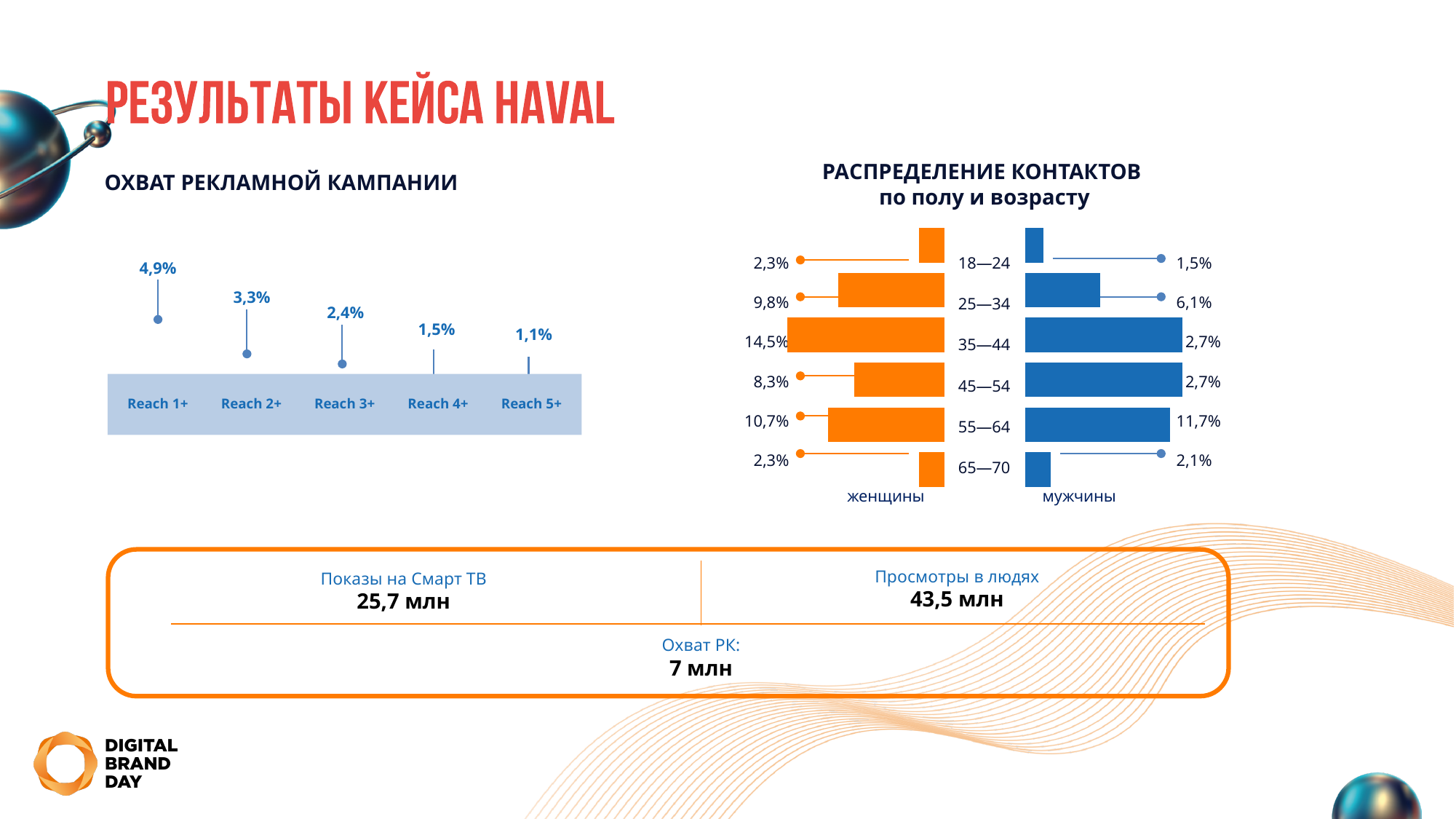
In the chart 'ОХВАТ РЕКЛАМНОЙ КАМПАНИИ', which category has the lowest value? Reach 5+ In the chart 'РАСПРЕДЕЛЕНИЕ КОНТАКТОВ по полу и возрасту', what is the value for женщины aged 35—44? 14,5% In the chart 'ОХВАТ РЕКЛАМНОЙ КАМПАНИИ', what is the value for Reach 1+? 4,9% How many categories are shown in the chart 'ОХВАТ РЕКЛАМНОЙ КАМПАНИИ'? 5 In the chart 'ОХВАТ РЕКЛАМНОЙ КАМПАНИИ', what is the difference between Reach 1+ and Reach 2+? 1,6% How many age groups are shown in the chart 'РАСПРЕДЕЛЕНИЕ КОНТАКТОВ по полу и возрасту'? 6 In the chart 'РАСПРЕДЕЛЕНИЕ КОНТАКТОВ по полу и возрасту', what is the value for мужчины aged 55—64? 11,7% What type of chart is 'РАСПРЕДЕЛЕНИЕ КОНТАКТОВ по полу и возрасту'? bar chart In the chart 'РАСПРЕДЕЛЕНИЕ КОНТАКТОВ по полу и возрасту', which age group has the highest value for женщины? 35—44 In the chart 'ОХВАТ РЕКЛАМНОЙ КАМПАНИИ', what is the value for Reach 3+? 2,4% In the chart 'РАСПРЕДЕЛЕНИЕ КОНТАКТОВ по полу и возрасту', which is larger for the 25—34 age group: женщины or мужчины? женщины In the chart 'ОХВАТ РЕКЛАМНОЙ КАМПАНИИ', do the values rise or fall from Reach 1+ to Reach 5+? fall